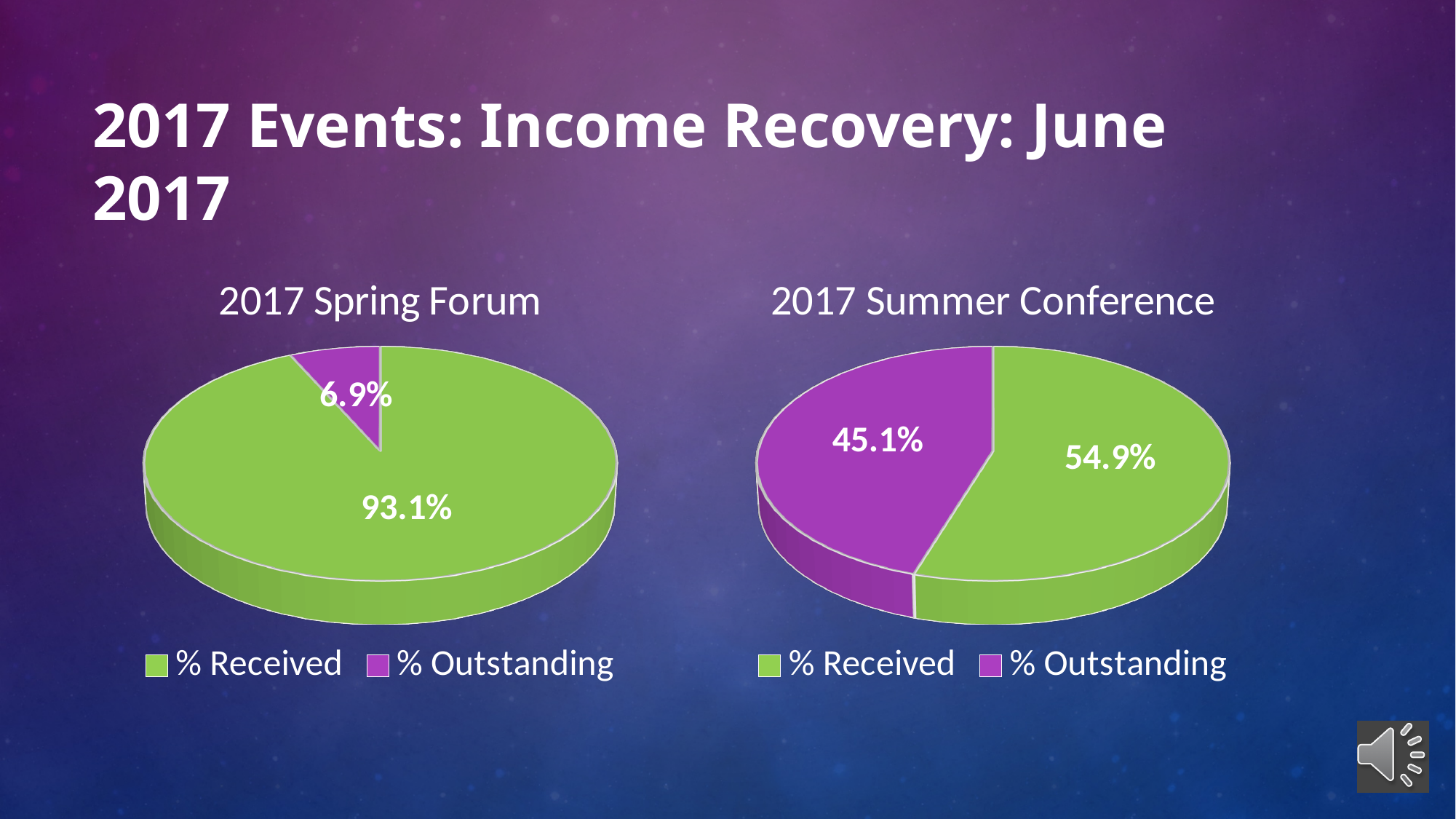
In the 2017 Summer Conference chart, what percentage is shown for % Received? 54.9% In the 2017 Summer Conference chart, which slice is the smallest? % Outstanding In the 2017 Spring Forum chart, what is the difference between % Received and % Outstanding? 86.2% In the 2017 Spring Forum chart, what percentage is shown for % Received? 93.1% In the 2017 Spring Forum chart, what colour represents % Outstanding? Purple In the 2017 Spring Forum chart, which slice is the largest? % Received In the 2017 Summer Conference chart, what percentage is shown for % Outstanding? 45.1% In the 2017 Summer Conference chart, what is the difference between % Received and % Outstanding? 9.8% How many slices does the 2017 Summer Conference chart have? 2 Which chart has the larger % Outstanding slice, 2017 Spring Forum or 2017 Summer Conference? 2017 Summer Conference What type of chart is the 2017 Spring Forum chart? Pie chart In the 2017 Spring Forum chart, what percentage is shown for % Outstanding? 6.9%